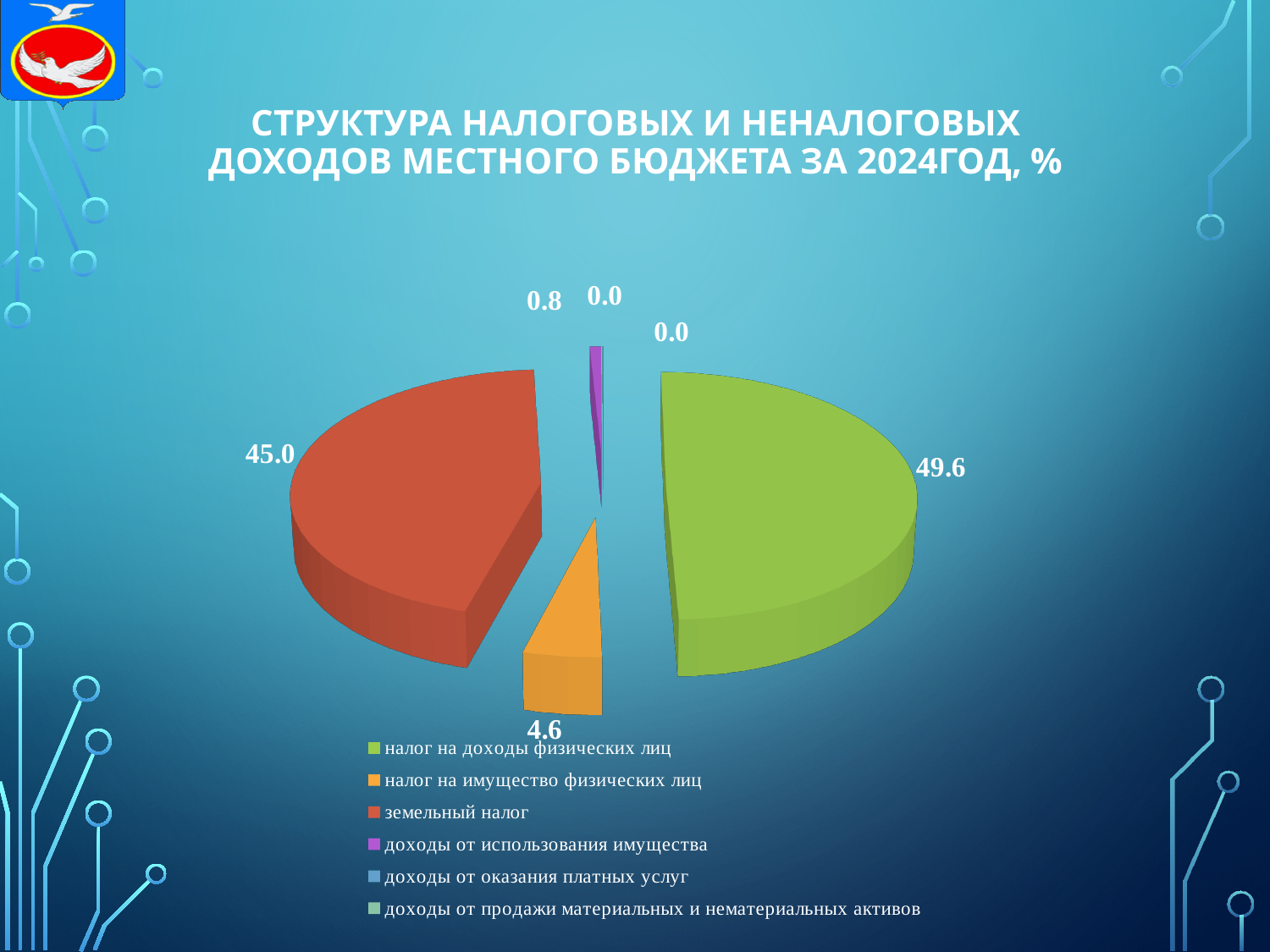
What is the value for земельный налог? 45.0 Which category has the largest share of the pie? налог на доходы физических лиц What is the difference between the values for налог на доходы физических лиц and земельный налог? 4.6 What is the value for налог на доходы физических лиц? 49.6 What year does the chart title refer to? 2024 How many entries does the legend list? 6 What is the value for налог на имущество физических лиц? 4.6 What colour is the slice for земельный налог? red What kind of chart is shown on the slide? pie chart What is the value shown for доходы от оказания платных услуг? 0.0 Which is larger, the value for земельный налог or the value for налог на имущество физических лиц? земельный налог What is the value for доходы от использования имущества? 0.8